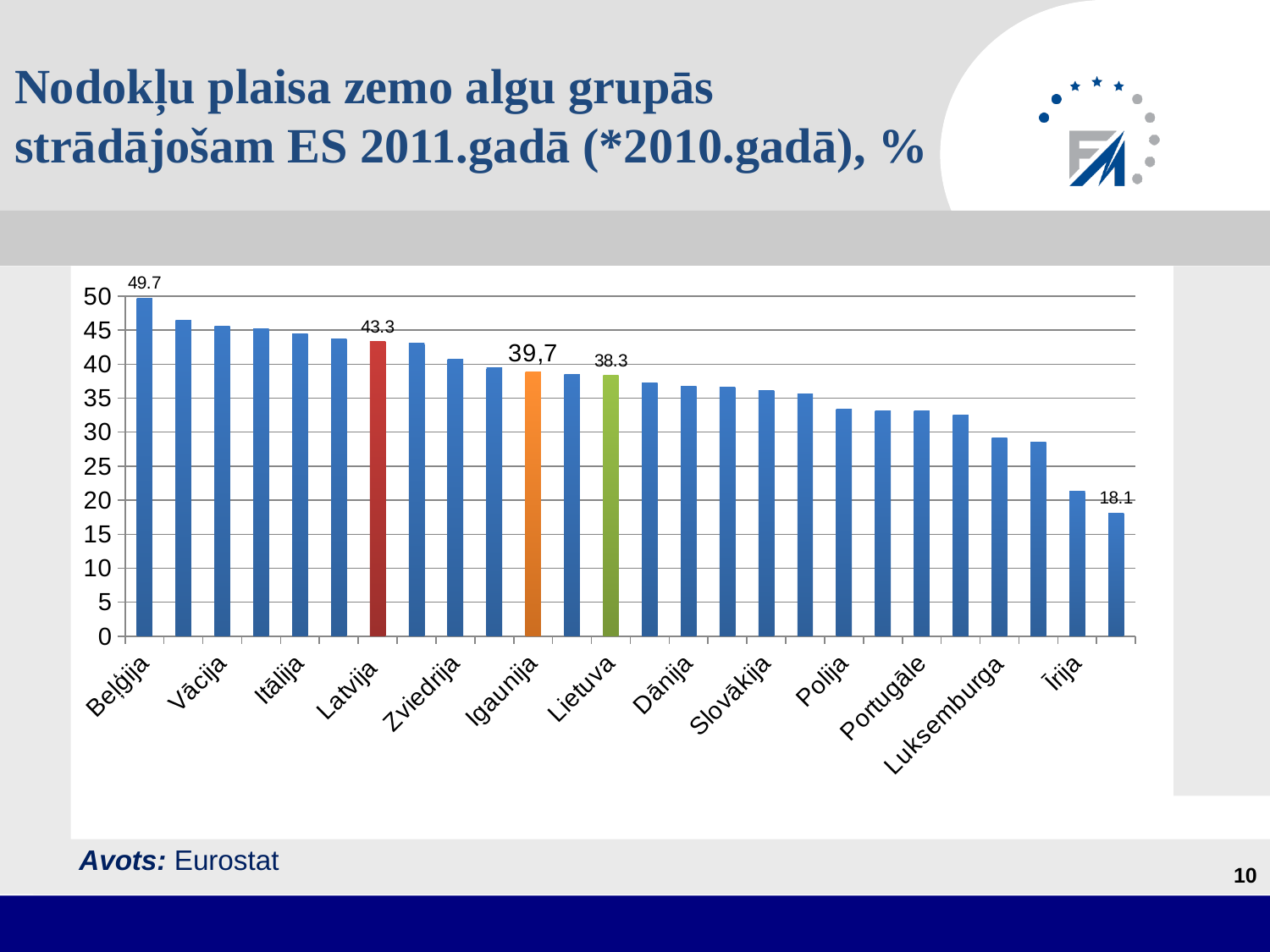
What is the value for Lietuva? 38.3 Is the value for Vācija greater or less than 40? greater What is the value for Latvija? 43.3 Is the value for Luksemburga greater or less than 35? less What is the difference between the values for Latvija and Lietuva? 5.0 What is the value for Igaunija? 39,7 What is the difference between the values for Beļģija and Latvija? 6.4 Which country has the highest value? Beļģija What kind of chart is shown on the slide? bar chart Which is larger, the value for Latvija or the value for Igaunija? Latvija What is the value for Beļģija? 49.7 How many bars are plotted in the chart? 26